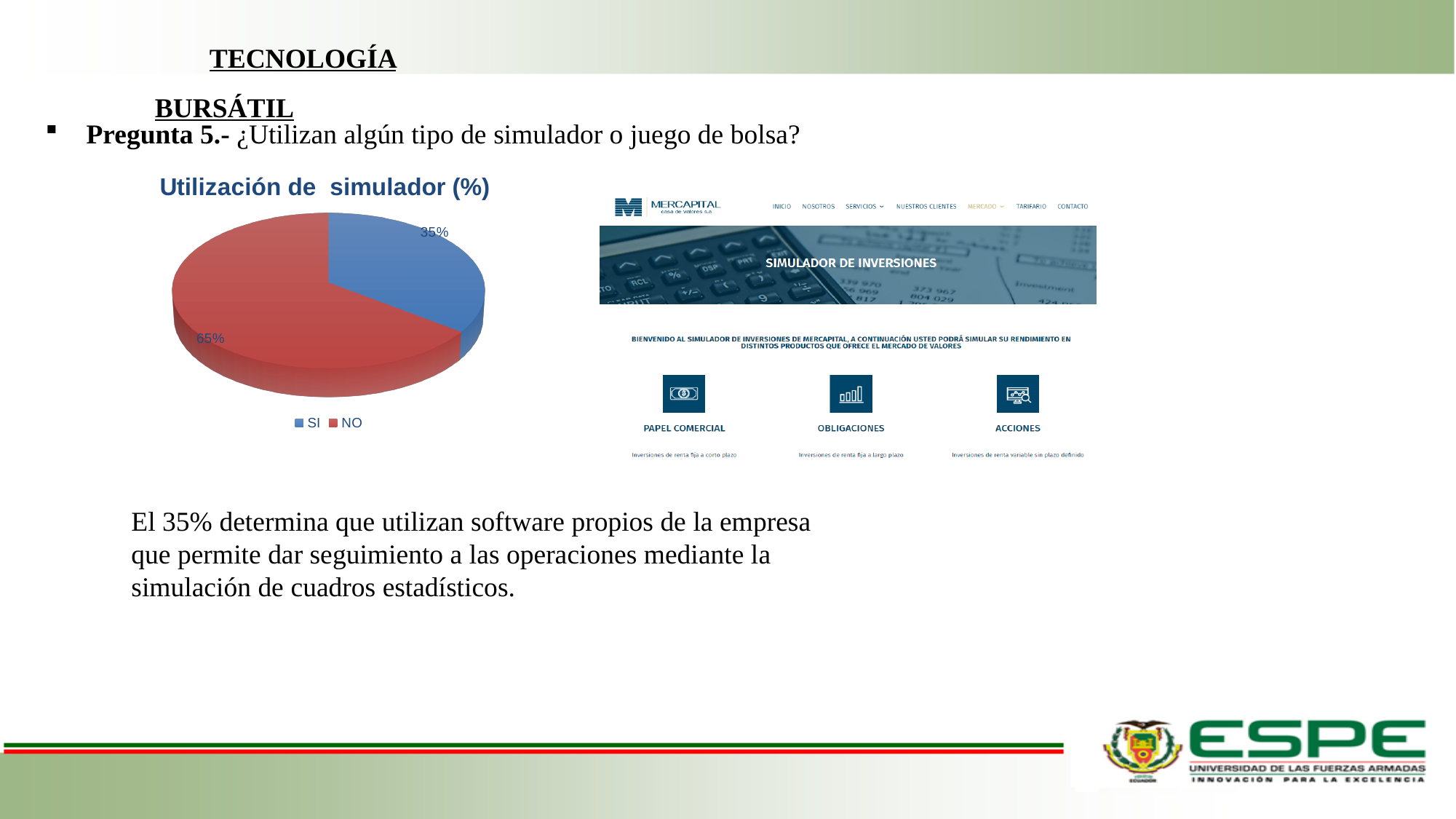
Which category has the smallest slice in the pie chart? SI What type of chart is shown under the title 'Utilización de simulador (%)'? Pie chart What colour is the NO slice in the pie chart? Red What is the value for SI in the pie chart? 35% What share of the pie does the SI slice represent? 35% Which is larger in the pie chart, SI or NO? NO Which category has the largest slice in the pie chart? NO What is the title of the pie chart? Utilización de simulador (%) How many categories does the pie chart show? 2 What is the value for NO in the pie chart? 65% What is the difference between the NO and SI slices in the pie chart? 30% How many entries does the legend of the pie chart list? 2